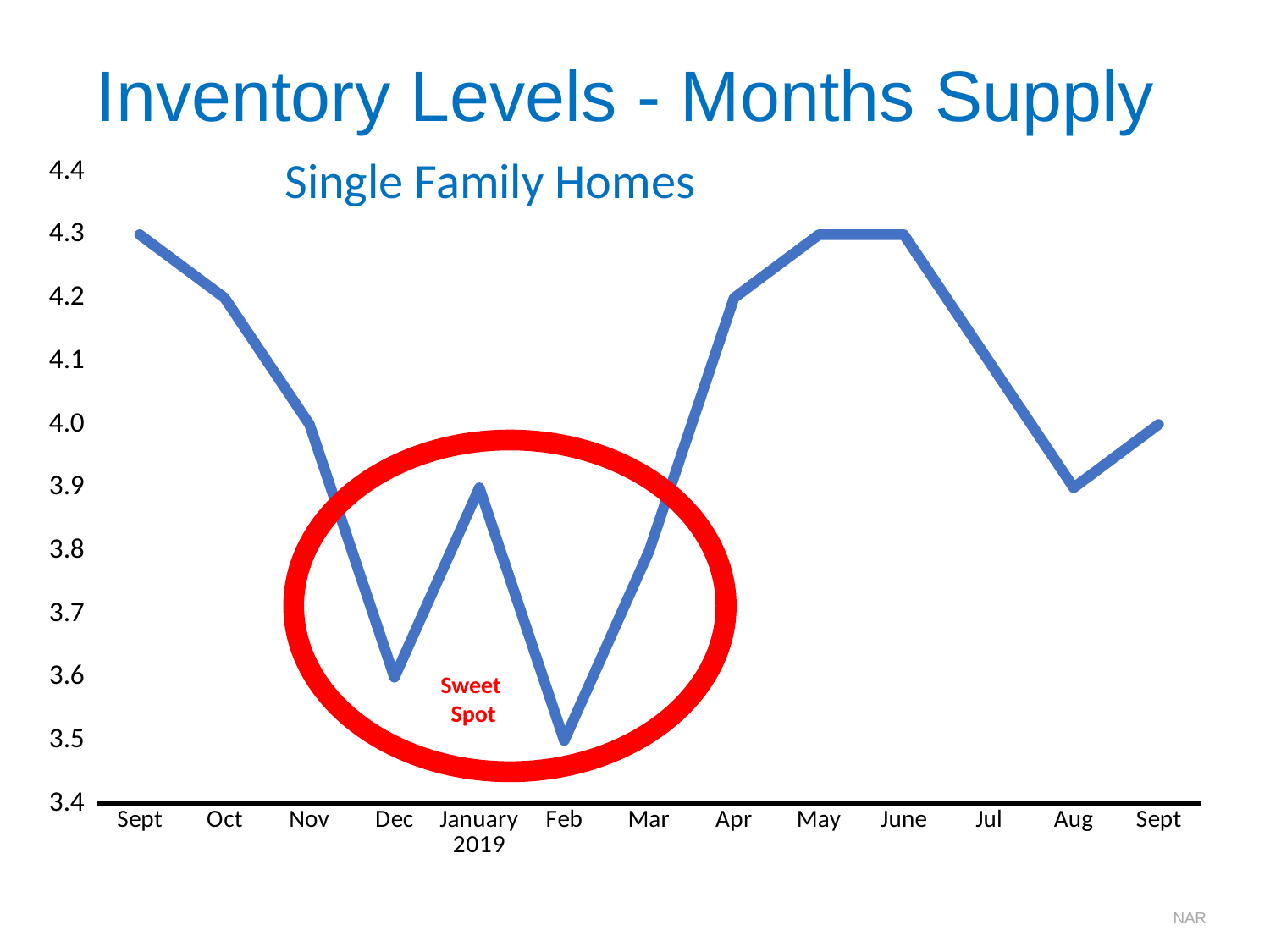
How many months (data points) are plotted on the x axis? 13 Is the value for Dec greater or less than 4.0? less What is the months supply value for Feb? 3.5 Is the value for May greater or less than 4.0? greater What kind of chart is shown on the slide? line chart What label is written inside the red circle on the chart? Sweet Spot Which is higher, the value for Dec or the value for Feb? Dec What is the months supply value for Dec? 3.6 Which month has the lowest months supply? Feb What is the difference between the value for January 2019 and the value for Feb? 0.4 Do the values rise or fall from Sept to Dec? fall What is the months supply value for January 2019? 3.9